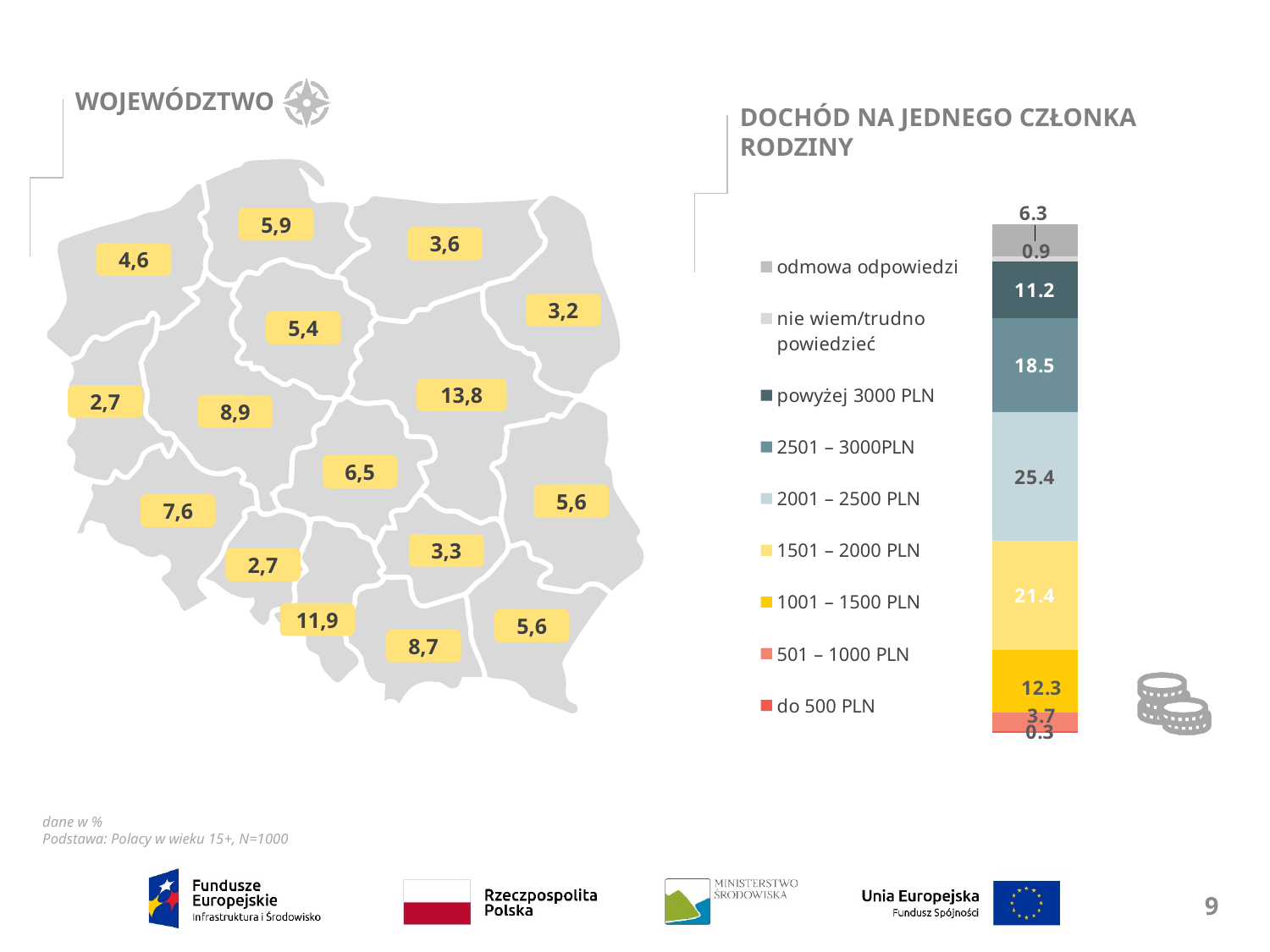
In the 'DOCHÓD NA JEDNEGO CZŁONKA RODZINY' chart, what is the difference between the '2001 – 2500 PLN' and '1501 – 2000 PLN' segments? 4.0 In the 'DOCHÓD NA JEDNEGO CZŁONKA RODZINY' chart, what is the value for 'odmowa odpowiedzi'? 6.3 In the 'DOCHÓD NA JEDNEGO CZŁONKA RODZINY' chart, what is the value for the '2001 – 2500 PLN' segment? 25.4 In the 'DOCHÓD NA JEDNEGO CZŁONKA RODZINY' chart, which is larger: '2501 – 3000PLN' or '1001 – 1500 PLN'? 2501 – 3000PLN How many categories does the legend of the 'DOCHÓD NA JEDNEGO CZŁONKA RODZINY' chart list? 9 On the 'WOJEWÓDZTWO' map, what is the highest value shown? 13,8 What type of chart is shown under the title 'DOCHÓD NA JEDNEGO CZŁONKA RODZINY'? Stacked bar chart In the 'DOCHÓD NA JEDNEGO CZŁONKA RODZINY' chart, which income category has the largest segment? 2001 – 2500 PLN In the 'DOCHÓD NA JEDNEGO CZŁONKA RODZINY' chart, which category has the smallest segment? do 500 PLN How many values are labelled on the 'WOJEWÓDZTWO' map? 16 In the 'DOCHÓD NA JEDNEGO CZŁONKA RODZINY' chart, what is the value for 'powyżej 3000 PLN'? 11.2 What is the total of all segments in the 'DOCHÓD NA JEDNEGO CZŁONKA RODZINY' stacked bar? 100.0